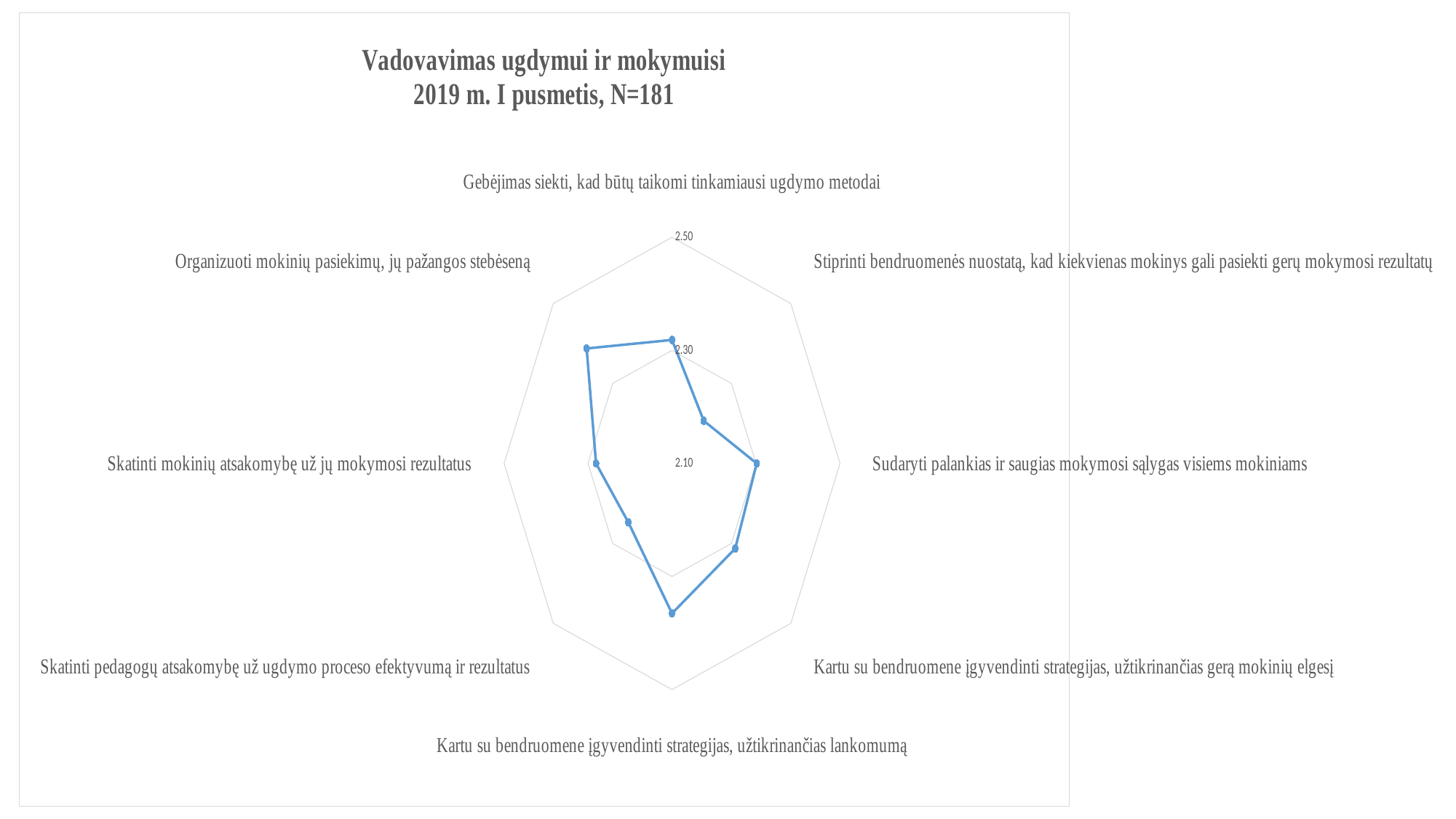
How many categories (axes) does the radar chart have? 8 What is the highest value shown on the chart's scale? 2.50 Which category has the lowest value on the radar chart? Stiprinti bendruomenės nuostatą, kad kiekvienas mokinys gali pasiekti gerų mokymosi rezultatų Is the value for 'Sudaryti palankias ir saugias mokymosi sąlygas visiems mokiniams' greater or less than 2.50? less Which is larger: the value for 'Kartu su bendruomene įgyvendinti strategijas, užtikrinančias lankomumą' or for 'Stiprinti bendruomenės nuostatą, kad kiekvienas mokinys gali pasiekti gerų mokymosi rezultatų'? Kartu su bendruomene įgyvendinti strategijas, užtikrinančias lankomumą What kind of chart is shown on the slide? radar chart Is the value for 'Skatinti mokinių atsakomybę už jų mokymosi rezultatus' greater or less than 2.30? less Which is larger: the value for 'Organizuoti mokinių pasiekimų, jų pažangos stebėseną' or for 'Skatinti pedagogų atsakomybę už ugdymo proceso efektyvumą ir rezultatus'? Organizuoti mokinių pasiekimų, jų pažangos stebėseną Is the value for 'Organizuoti mokinių pasiekimų, jų pažangos stebėseną' greater or less than 2.30? greater What is the title of the chart? Vadovavimas ugdymui ir mokymuisi 2019 m. I pusmetis, N=181